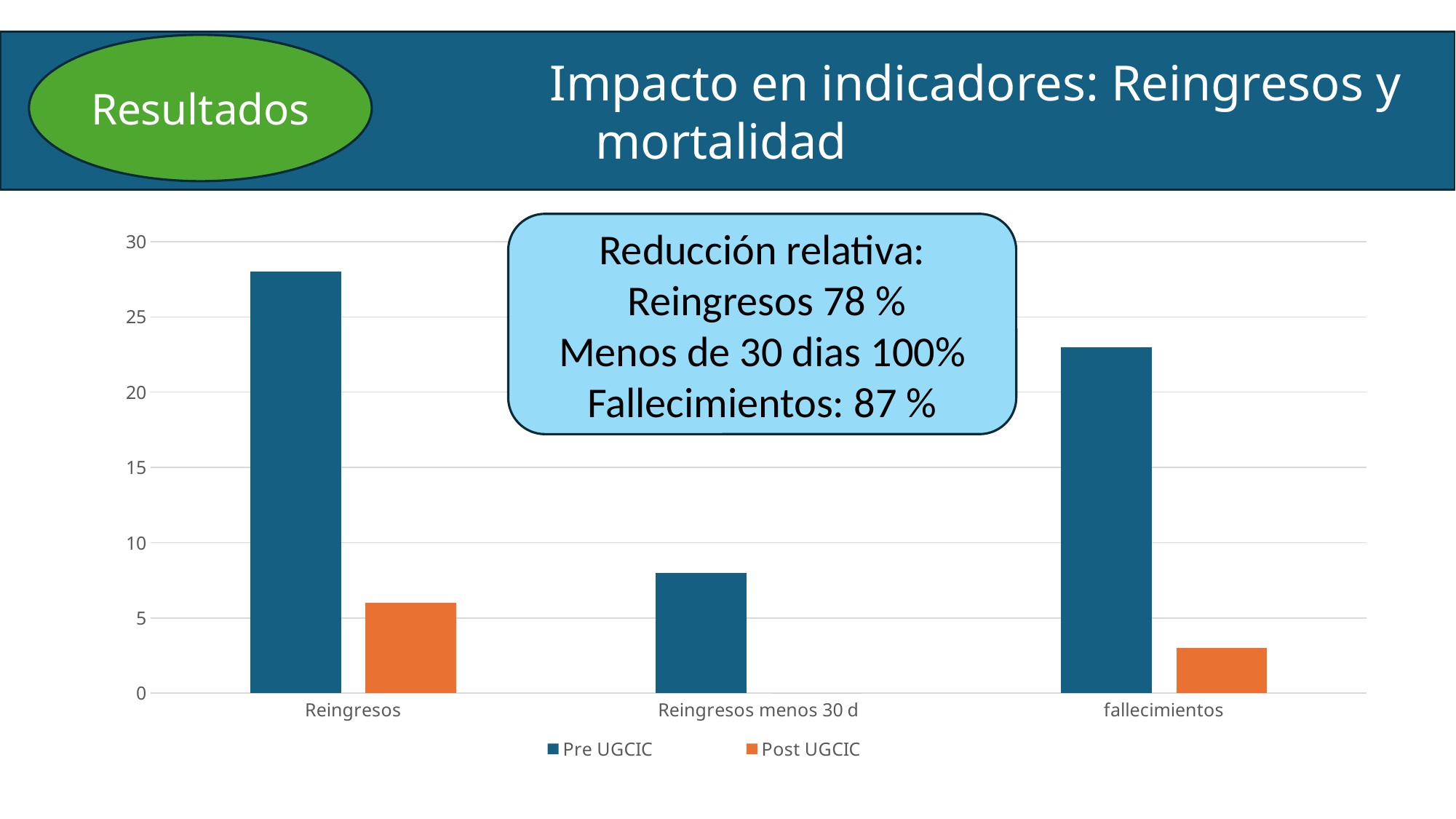
Which is larger for fallecimientos, the Pre UGCIC value or the Post UGCIC value? Pre UGCIC What kind of chart is shown on the slide? bar chart Is the Pre UGCIC value for Reingresos greater or less than 25? greater How many series does the chart legend list? 2 Is the Pre UGCIC value for Reingresos menos 30 d greater or less than 10? less How many categories are shown on the x axis of the chart? 3 Which category has the lowest Pre UGCIC value? Reingresos menos 30 d Is the Pre UGCIC value for fallecimientos greater or less than 20? greater According to the text box on the chart, what is the relative reduction in Reingresos? 78 % Which category has the highest Pre UGCIC value? Reingresos Which series is shown in orange in the chart? Post UGCIC